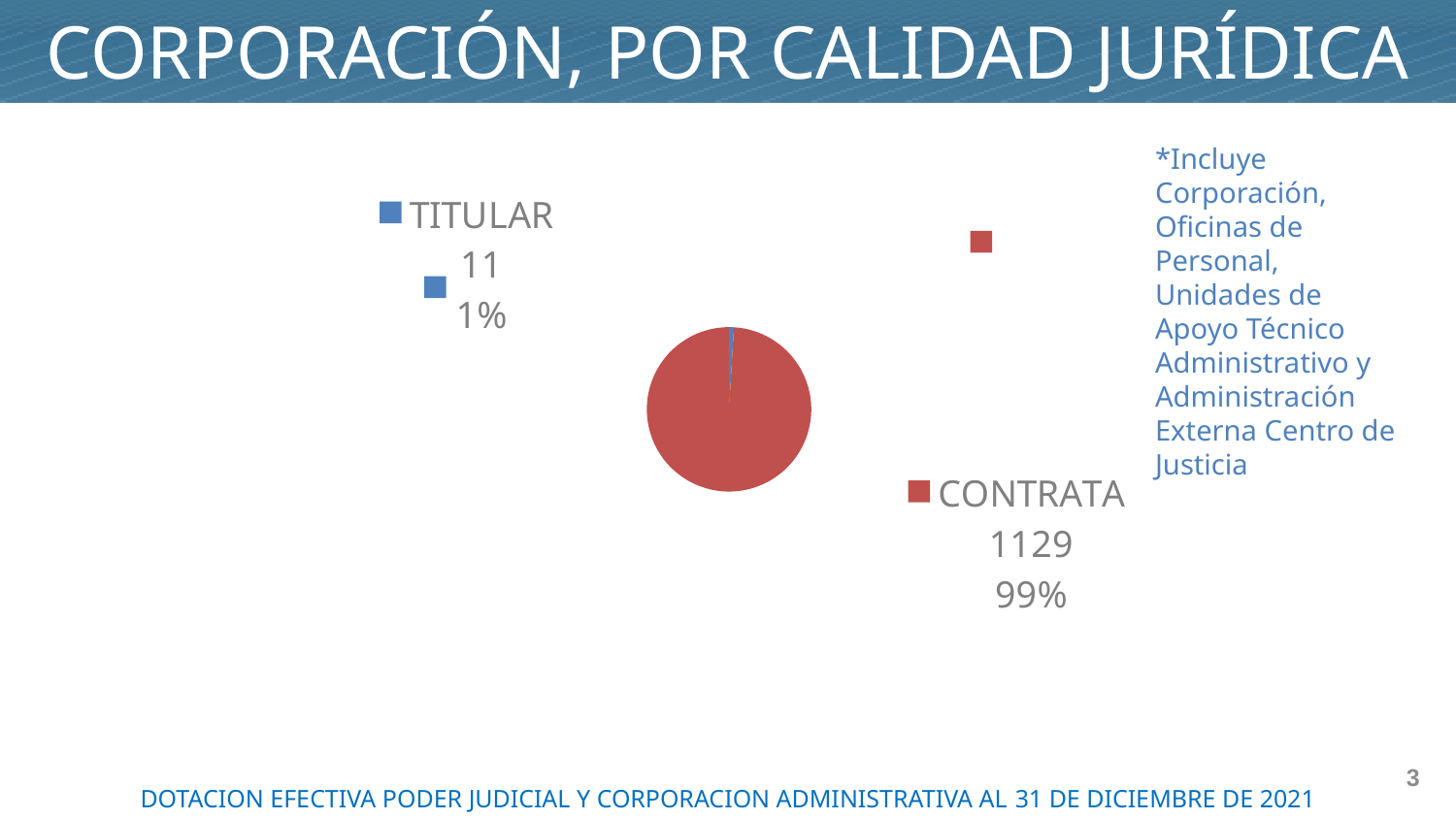
What share of the pie does TITULAR represent? 1% What is the difference between the values for CONTRATA and TITULAR? 1118 How many categories are shown in the pie chart? 2 What is the value for CONTRATA? 1129 What share of the pie does CONTRATA represent? 99% Which is larger, the value for TITULAR or the value for CONTRATA? CONTRATA What kind of chart is shown on the slide? pie chart What colour is the CONTRATA slice of the pie? red Which category has the largest slice of the pie? CONTRATA What is the total of the two values shown in the pie chart? 1140 What is the value for TITULAR? 11 Which category has the smallest slice of the pie? TITULAR